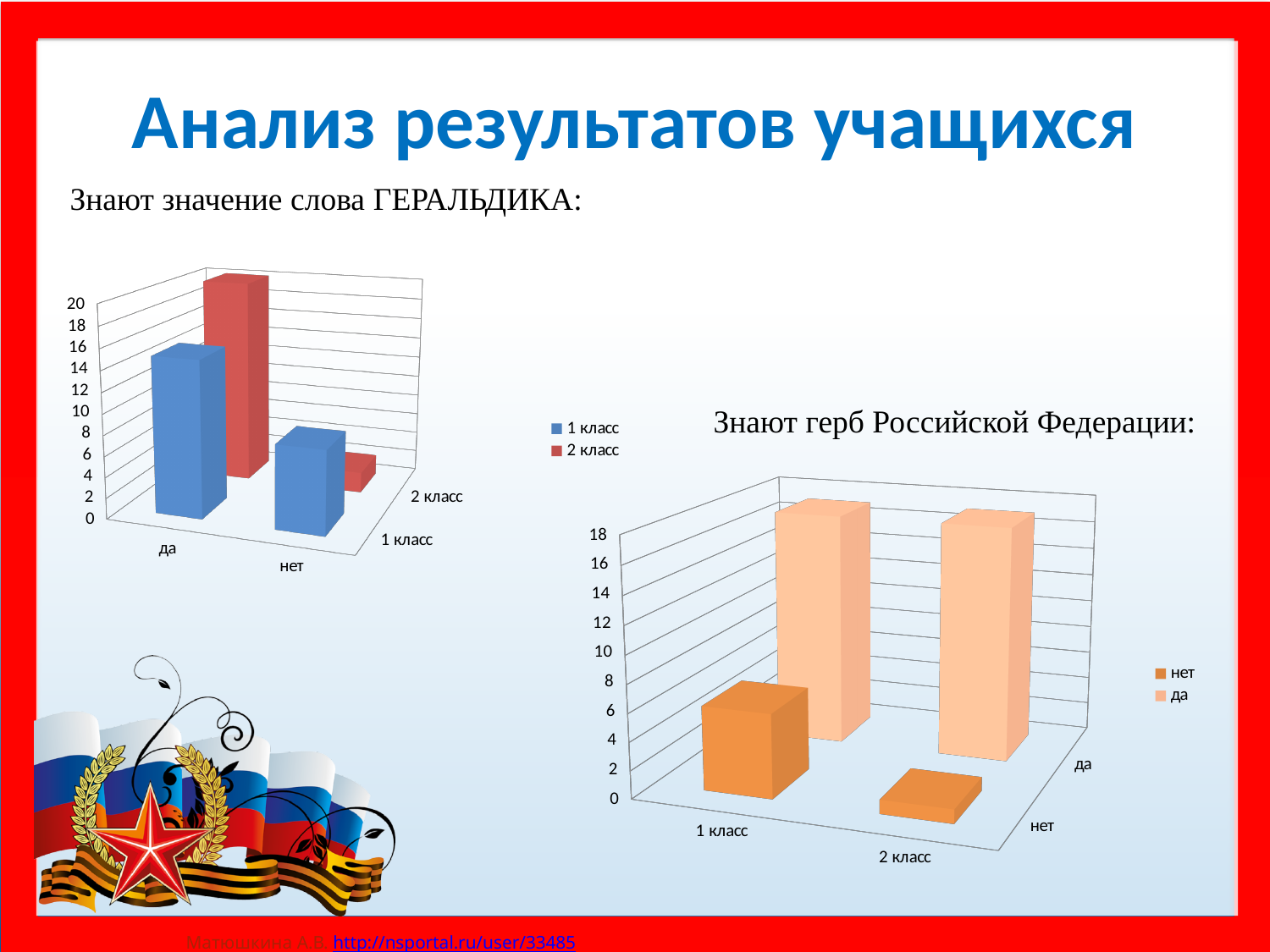
In the chart titled 'Знают значение слова ГЕРАЛЬДИКА', how many series does the legend list? 2 In the chart titled 'Знают значение слова ГЕРАЛЬДИКА', which category and series has the shortest bar? нет, 2 класс In the chart titled 'Знают значение слова ГЕРАЛЬДИКА', is the value for 'да' in 2 класс greater or less than 10? greater In the chart titled 'Знают значение слова ГЕРАЛЬДИКА', for the category 'да', which series has the larger value, 1 класс or 2 класс? 2 класс In the chart titled 'Знают значение слова ГЕРАЛЬДИКА', which series is shown in red? 2 класс In the chart titled 'Знают значение слова ГЕРАЛЬДИКА', what kind of chart is shown? bar chart In the chart titled 'Знают значение слова ГЕРАЛЬДИКА', is the value for 'нет' in 1 класс greater or less than 10? less In the chart titled 'Знают герб Российской Федерации', how many categories are shown on the x axis? 2 In the chart titled 'Знают герб Российской Федерации', which series is shown in the darker orange colour? нет In the chart titled 'Знают герб Российской Федерации', for the series 'нет', which class has the larger value, 1 класс or 2 класс? 1 класс In the chart titled 'Знают герб Российской Федерации', is the value for 'да' in 1 класс greater or less than 10? greater In the chart titled 'Знают значение слова ГЕРАЛЬДИКА', which category and series has the tallest bar? да, 2 класс